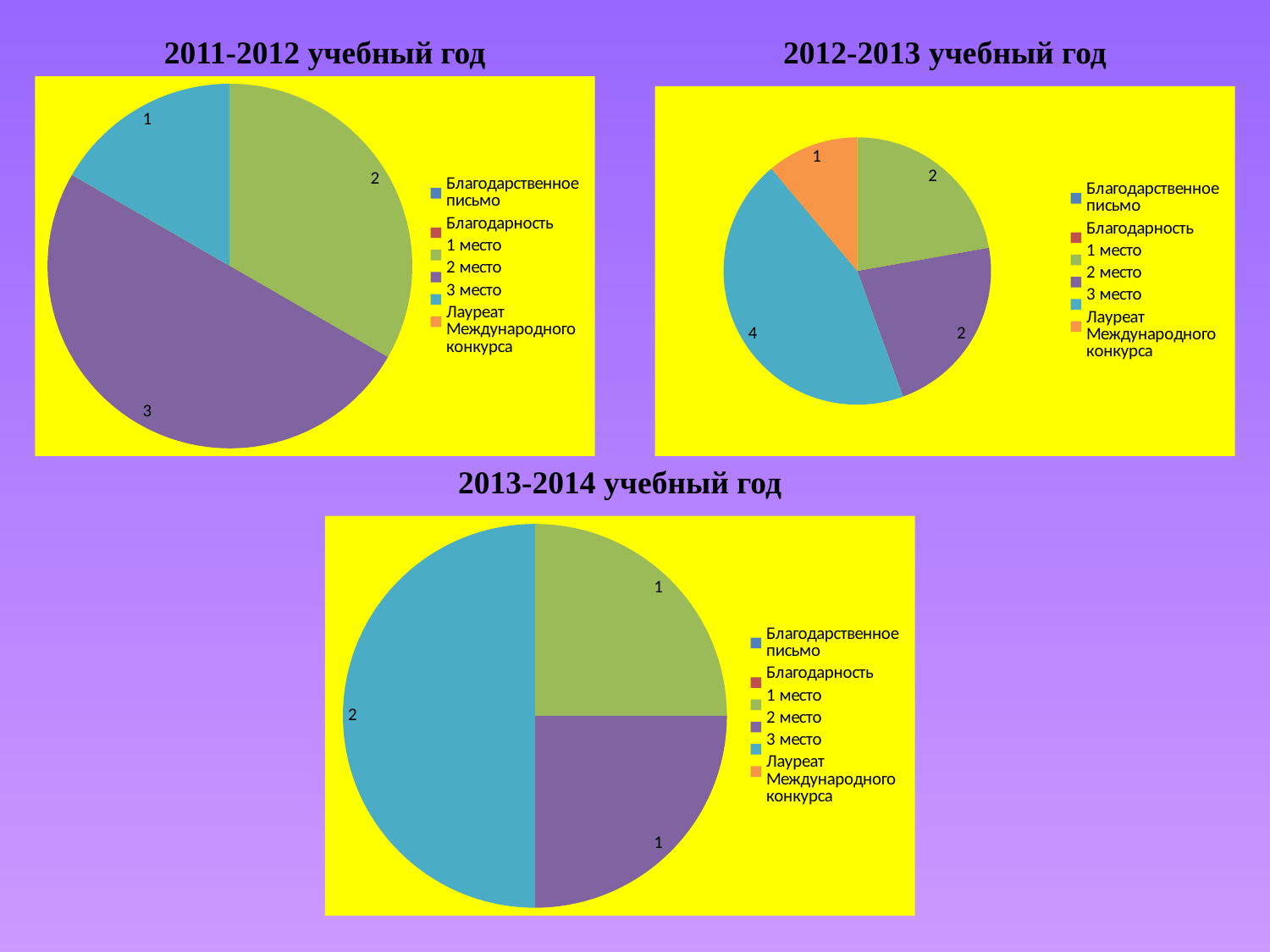
In the 2011-2012 учебный год chart, what is the value for 3 место? 1 In the 2013-2014 учебный год chart, which is larger, 3 место or 1 место? 3 место In the 2011-2012 учебный год chart, what is the total of all slices? 6 In the 2012-2013 учебный год chart, how many slices does the pie have? 4 In the 2012-2013 учебный год chart, what is the value for 3 место? 4 How many entries does the legend of the 2013-2014 учебный год chart list? 6 In the 2012-2013 учебный год chart, what is the difference between the values for 3 место and 1 место? 2 In the 2011-2012 учебный год chart, what share of the pie does 2 место take? 50% In the 2011-2012 учебный год chart, which category has the largest slice? 2 место What type of chart is used on the slide for the 2011-2012 учебный год? Pie chart In the 2012-2013 учебный год chart, what is the value for Лауреат Международного конкурса? 1 In the 2011-2012 учебный год chart, what is the value for 2 место? 3